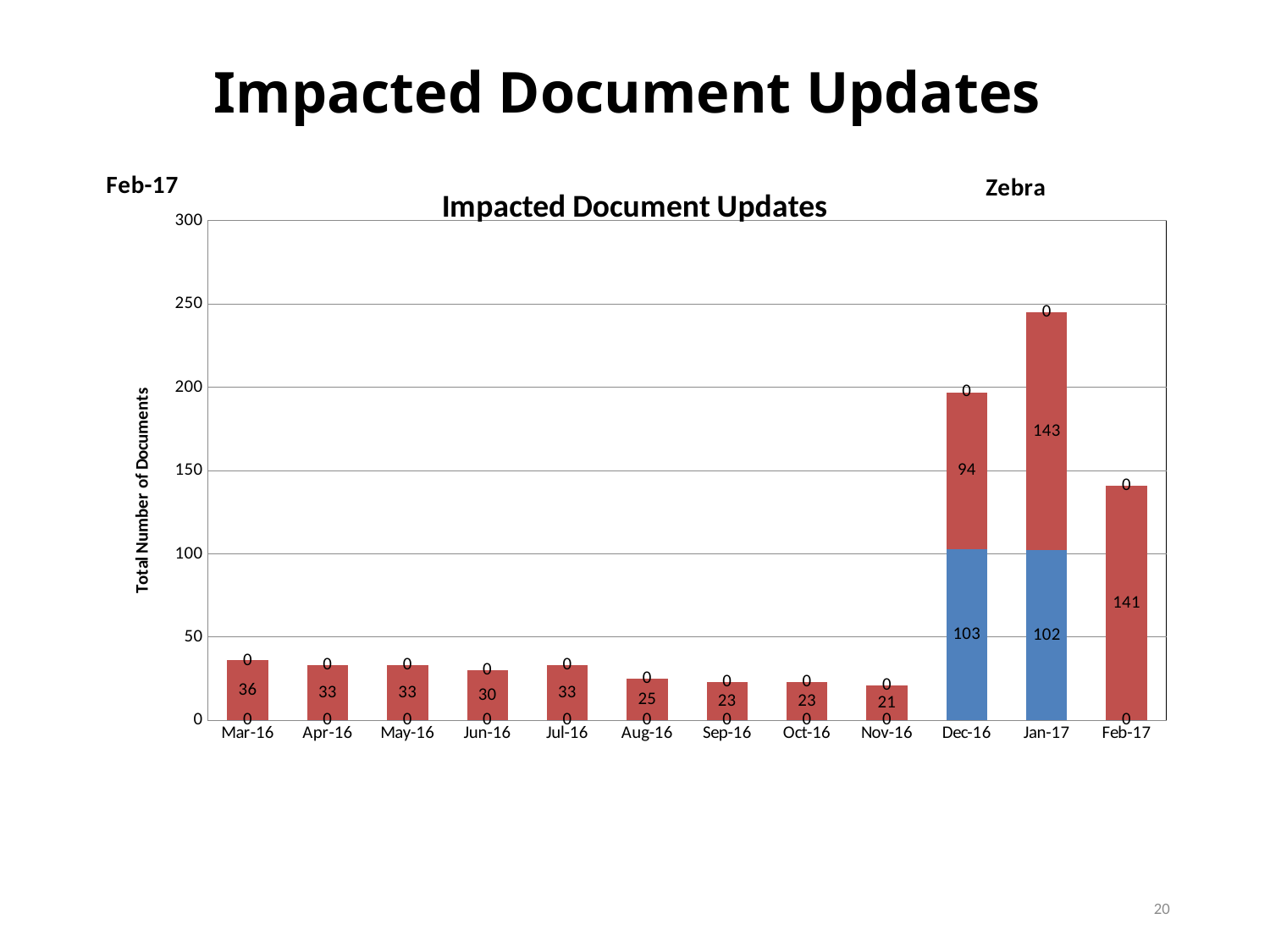
What is the value labelled on the red segment of the Jan-17 bar? 143 How many months are shown on the x axis? 12 Which month has the tallest bar? Jan-17 What is the value labelled on the bar for Feb-17? 141 Which month has the shortest bar? Nov-16 What is the difference between the red segment values for Jan-17 (143) and Dec-16 (94)? 49 What is the total of the stacked bar for Dec-16 (blue plus red segments)? 197 What is the total of the stacked bar for Jan-17 (blue plus red segments)? 245 What is the title of the vertical axis? Total Number of Documents What is the value labelled on the blue segment of the Dec-16 bar? 103 Is the total height of the Jan-17 bar greater or less than 200? greater What is the value labelled on the red bar for Mar-16? 36